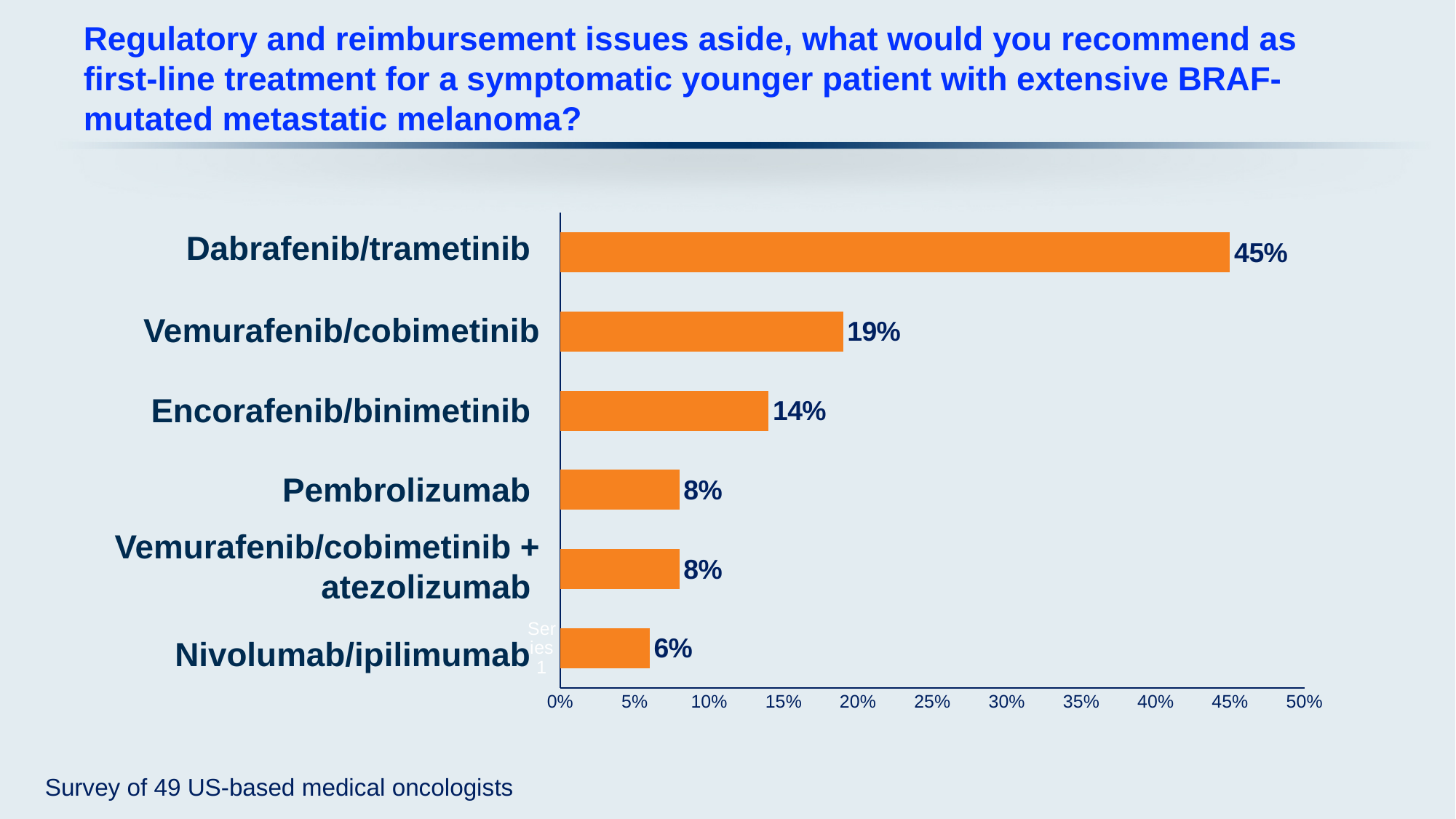
Which treatment received the lowest percentage of recommendations? Nivolumab/ipilimumab What percentage of respondents recommended Vemurafenib/cobimetinib? 19% What percentage of respondents recommended Encorafenib/binimetinib? 14% How many treatment options are shown in the chart? 6 How many medical oncologists were surveyed, according to the note on the slide? 49 What type of chart is shown on the slide? Bar chart What percentage of respondents recommended Nivolumab/ipilimumab? 6% Is the value for Dabrafenib/trametinib greater or less than 40%? greater What is the difference in percentage points between Dabrafenib/trametinib and Vemurafenib/cobimetinib? 26 What percentage of respondents recommended Dabrafenib/trametinib? 45% Which received a higher percentage: Encorafenib/binimetinib or Pembrolizumab? Encorafenib/binimetinib Which treatment received the highest percentage of recommendations? Dabrafenib/trametinib